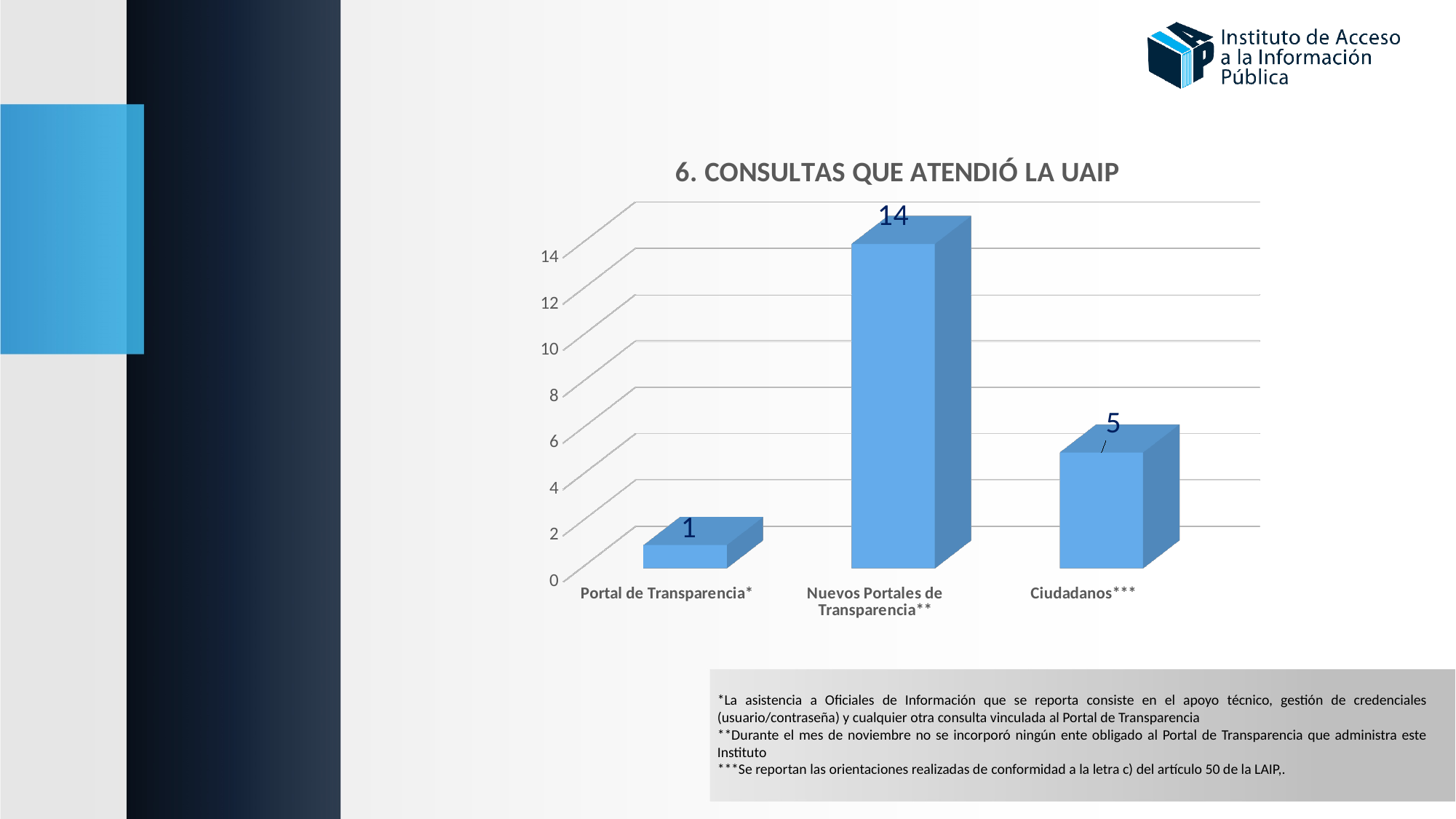
What is the value for Ciudadanos***? 5 Which category has the highest value? Nuevos Portales de Transparencia** What is the value for Portal de Transparencia*? 1 What is the value for Nuevos Portales de Transparencia**? 14 Is the value for Ciudadanos*** greater or less than 10? less How many categories are shown on the chart? 3 Which is larger, the value for Ciudadanos*** or the value for Portal de Transparencia*? Ciudadanos*** What is the difference between the values for Ciudadanos*** and Portal de Transparencia*? 4 Which category has the lowest value? Portal de Transparencia* What kind of chart is shown on the slide? bar chart What is the difference between the values for Nuevos Portales de Transparencia** and Ciudadanos***? 9 What is the title of the chart? 6. CONSULTAS QUE ATENDIÓ LA UAIP